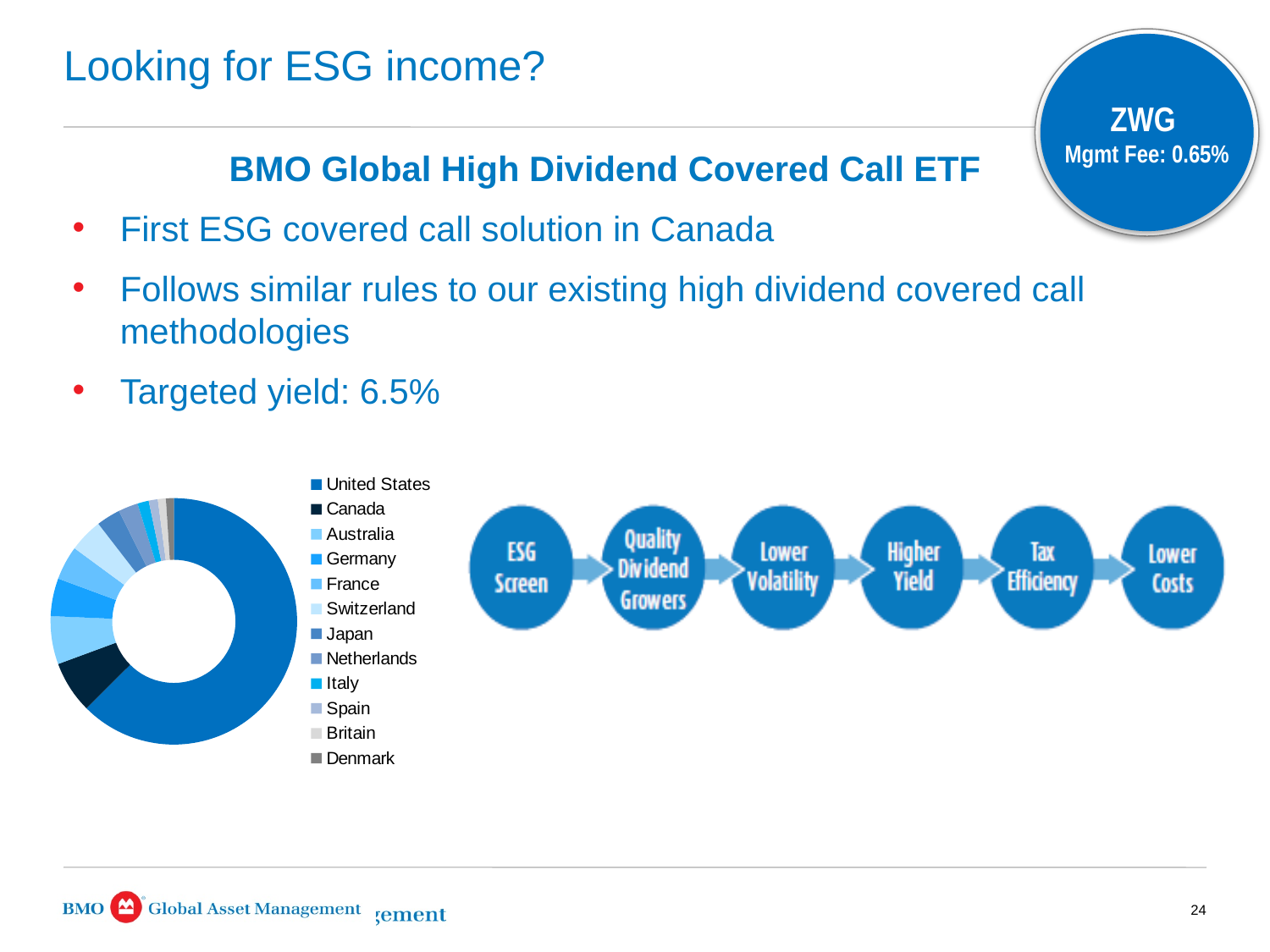
How many countries are listed in the legend of the donut chart? 12 Which country is listed first in the legend of the donut chart? United States Does the United States slice of the donut chart account for more or less than half of the chart? more Which is larger in the donut chart, the slice for Canada or the slice for Denmark? Canada Which country is listed last in the legend of the donut chart? Denmark Which is larger in the donut chart, the slice for United States or the slice for Japan? United States Which country has the largest slice in the donut chart? United States What kind of chart is shown on the lower left of the slide? Donut (pie) chart Which is larger in the donut chart, the slice for United States or the slice for Canada? United States